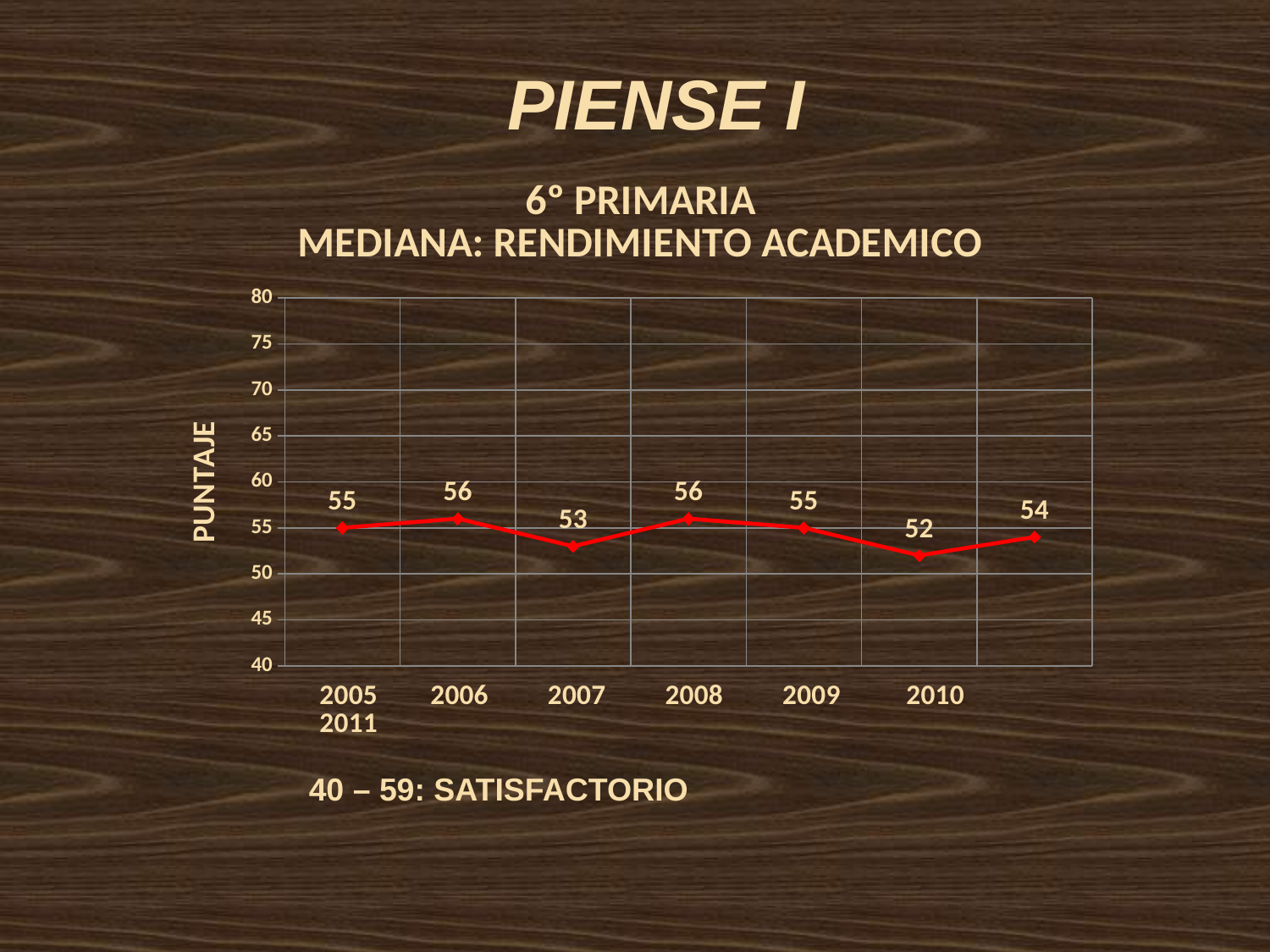
Which is larger, the value for 2006 or the value for 2007? 2006 What is the value for 2010? 52 What is the value of the last (rightmost) point on the line? 54 What is the value for 2005? 55 What is the value for 2009? 55 What is the difference between the values for 2008 and 2010? 4 Which year has the lowest value? 2010 What is the value for 2007? 53 Is the value for 2010 greater or less than 55? less How many data points are plotted on the line? 7 What is the label of the vertical axis? PUNTAJE What kind of chart is shown? line chart